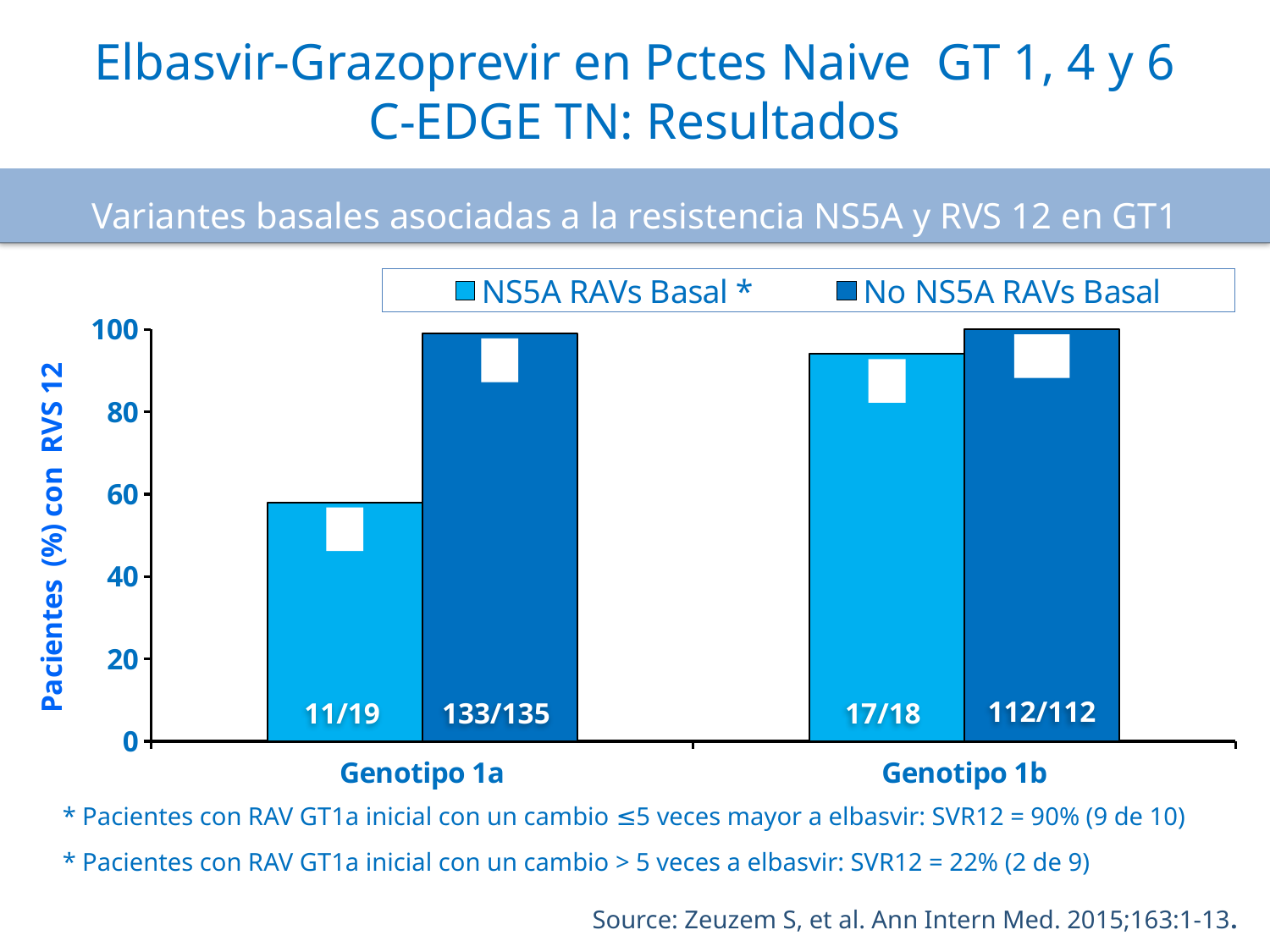
What data label is printed on the No NS5A RAVs Basal bar for Genotipo 1b? 112/112 How many series does the legend list? 2 How many genotype categories are shown on the x axis? 2 What data label is printed on the NS5A RAVs Basal bar for Genotipo 1a? 11/19 Which bar is the lowest in the chart? NS5A RAVs Basal, Genotipo 1a Is the NS5A RAVs Basal bar for Genotipo 1a greater or less than 40? greater What kind of chart is shown on the slide? bar chart What data label is printed on the No NS5A RAVs Basal bar for Genotipo 1a? 133/135 Is the NS5A RAVs Basal bar for Genotipo 1b greater or less than 80? greater What data label is printed on the NS5A RAVs Basal bar for Genotipo 1b? 17/18 For Genotipo 1a, which series has the higher bar: NS5A RAVs Basal or No NS5A RAVs Basal? No NS5A RAVs Basal What is the title of the y axis? Pacientes (%) con RVS 12